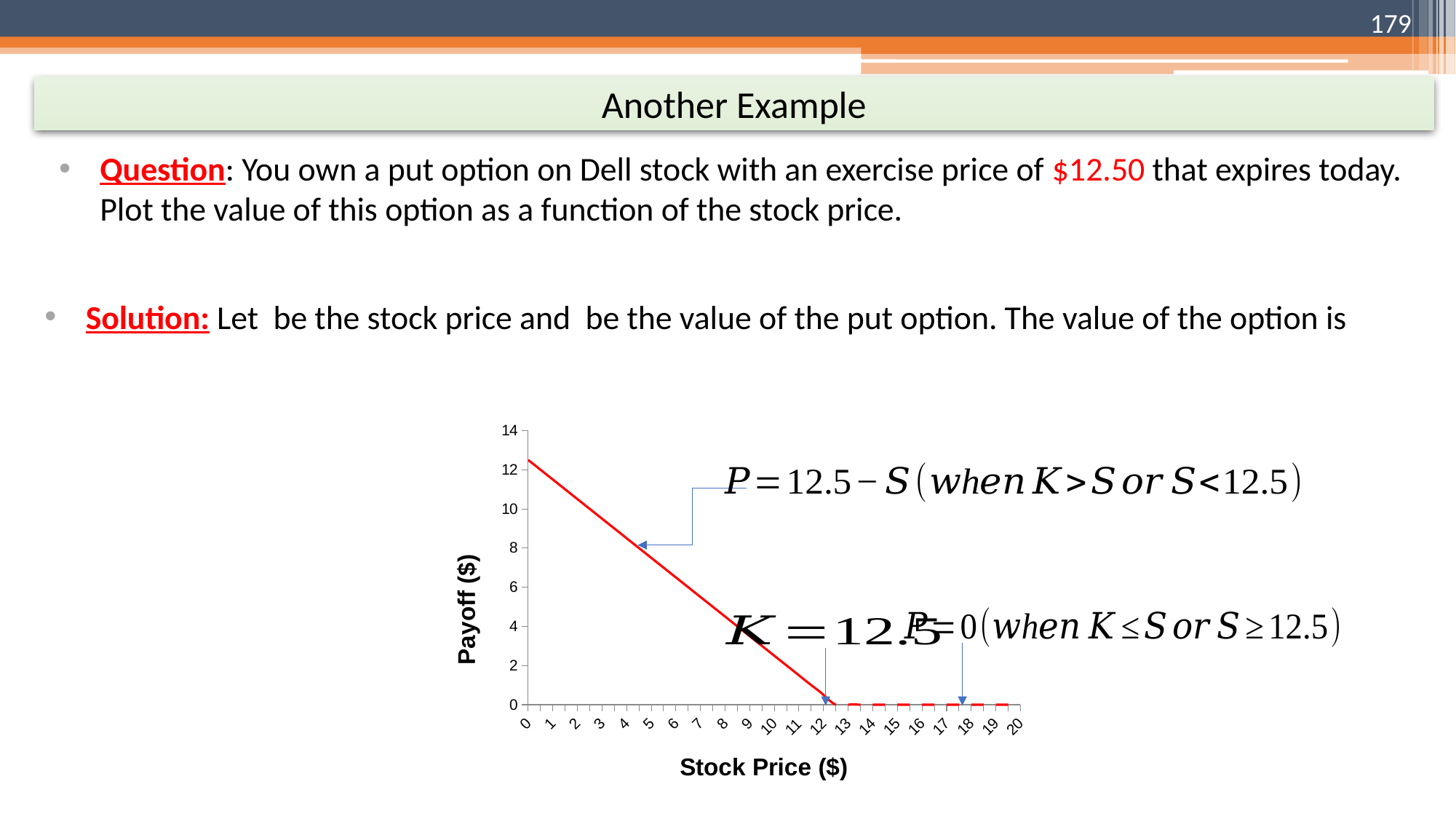
What is the title of the x axis of the chart? Stock Price ($) Is the payoff at a stock price of 8 greater or less than 4? greater Is the payoff at a stock price of 2 greater or less than 10? greater Is the payoff at a stock price of 10 greater or less than 2? greater How does the payoff change as the stock price increases from 0 to 12? it falls What is the payoff when the stock price is 20? 0 What kind of chart is shown on the slide? line chart Which stock price has the larger payoff, 2 or 8? 2 What is the payoff when the stock price is 15? 0 What is the title of the y axis of the chart? Payoff ($) At which stock price is the payoff highest? 0